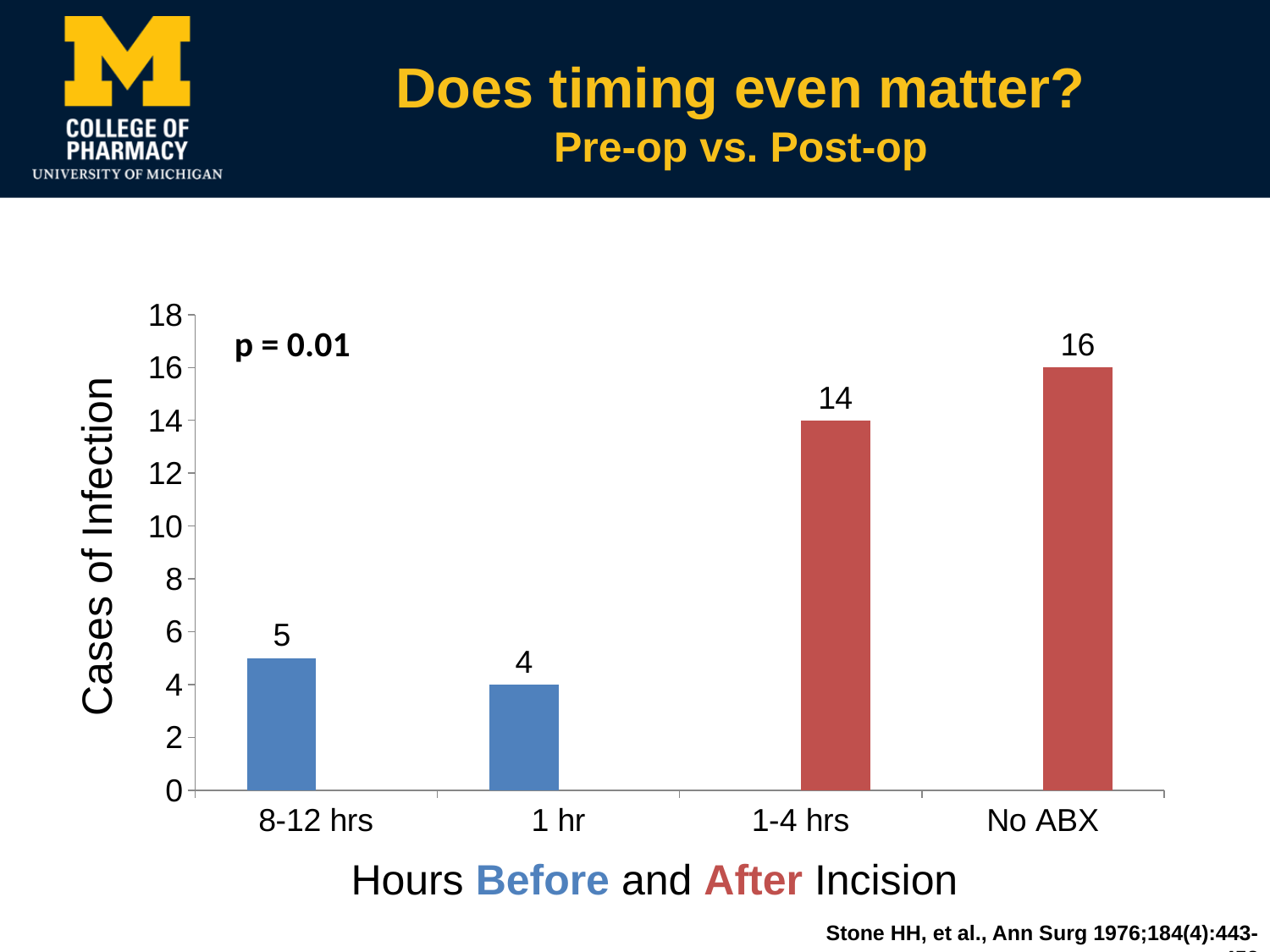
How many categories are shown on the x axis of the chart? 4 How many cases of infection are shown for the 1 hr category? 4 Which has more cases of infection, 8-12 hrs or 1-4 hrs? 1-4 hrs What is the difference in cases of infection between No ABX and 1 hr? 12 What is the difference in cases of infection between 1-4 hrs and 8-12 hrs? 9 How many cases of infection are shown for the No ABX category? 16 What type of chart is shown on the slide? Bar chart Which category has the highest number of cases of infection? No ABX How many cases of infection are shown for the 1-4 hrs category? 14 Which category has the lowest number of cases of infection? 1 hr What is the label of the y axis of the chart? Cases of Infection How many cases of infection are shown for the 8-12 hrs category? 5